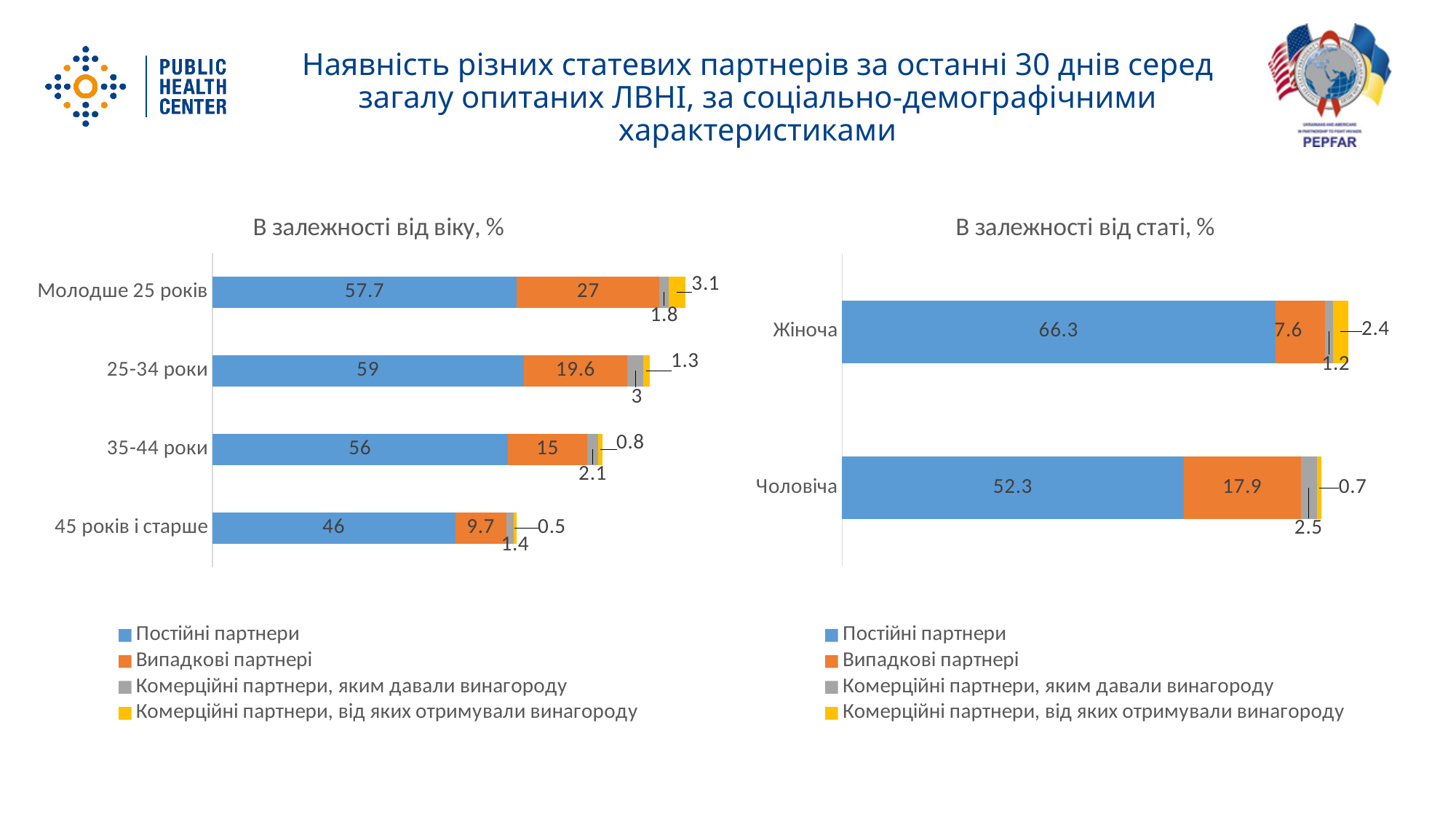
In the chart 'В залежності від віку, %', which age group has the lowest value for 'Випадкові партнері'? 45 років і старше In the chart 'В залежності від віку, %', which age group has the highest value for 'Постійні партнери'? 25-34 роки In the chart 'В залежності від статі, %', what is the difference between 'Постійні партнери' for 'Жіноча' and for 'Чоловіча'? 14 In the chart 'В залежності від віку, %', which is larger: 'Випадкові партнері' for 'Молодше 25 років' or for '35-44 роки'? Молодше 25 років How many age groups are shown in the chart 'В залежності від віку, %'? 4 In the chart 'В залежності від статі, %', what is the total of the stacked bar for 'Чоловіча'? 73.4 In the chart 'В залежності від віку, %', what is the value of 'Випадкові партнері' for '45 років і старше'? 9.7 What type of chart is 'В залежності від статі, %'? Stacked bar chart In the chart 'В залежності від статі, %', what is the value of 'Комерційні партнери, від яких отримували винагороду' for 'Жіноча'? 2.4 In the chart 'В залежності від віку, %', what is the value of 'Постійні партнери' for 'Молодше 25 років'? 57.7 In the chart 'В залежності від статі, %', what is the value of 'Випадкові партнері' for 'Чоловіча'? 17.9 How many series does the legend of the chart 'В залежності від статі, %' list? 4